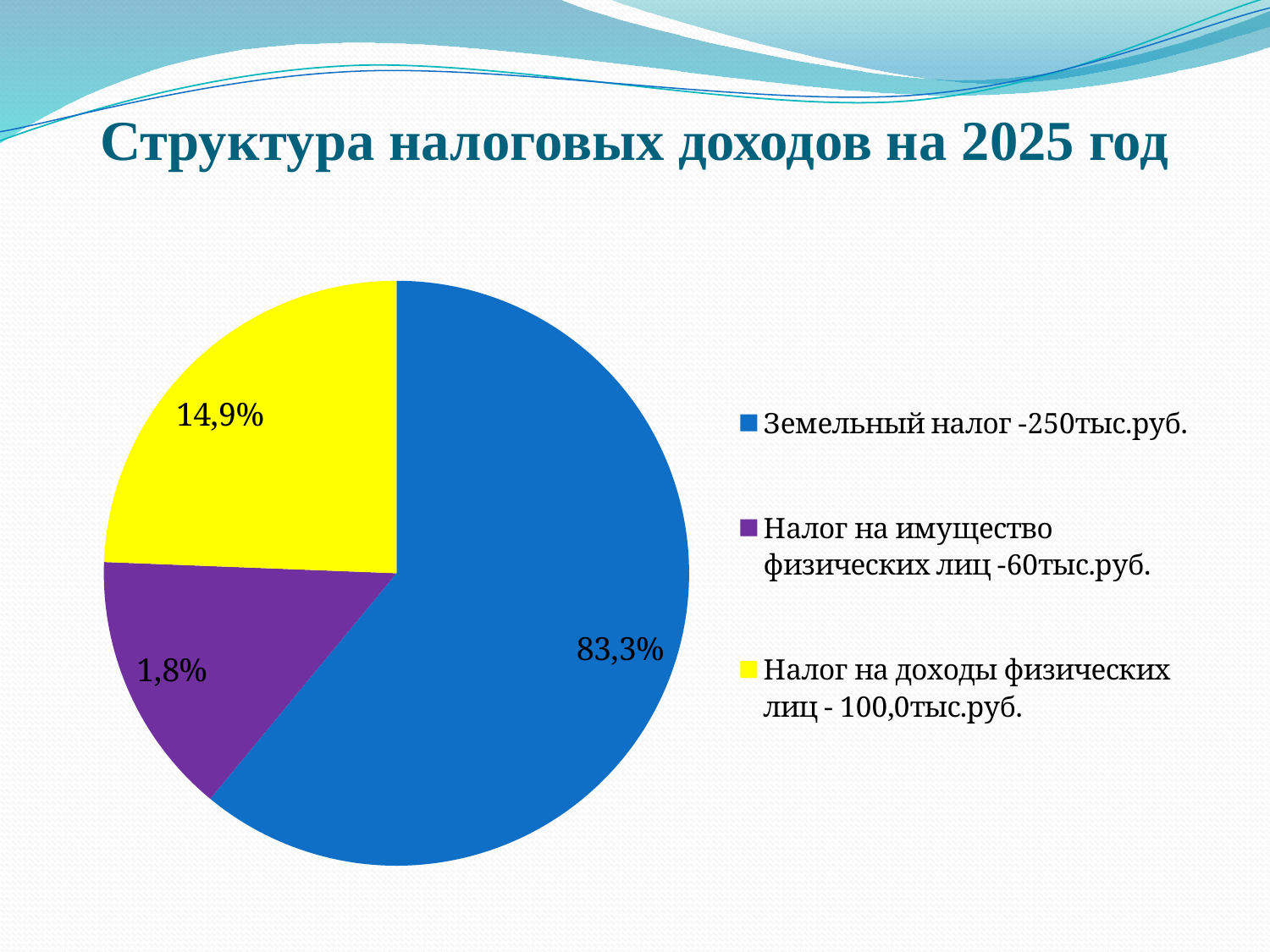
What percentage is shown for Налог на доходы физических лиц? 14,9% Which category has the largest share of the pie? Земельный налог What is the title of the chart on the slide? Структура налоговых доходов на 2025 год What type of chart is shown on the slide? Pie chart Which is larger: the share for Земельный налог or the share for Налог на доходы физических лиц? Земельный налог How many slices does the pie chart have? 3 What percentage is shown for Земельный налог? 83,3% What percentage is shown for Налог на имущество физических лиц? 1,8% What colour is the slice for Налог на доходы физических лиц? Yellow How many entries does the legend list? 3 What is the difference in percentage points between the Земельный налог share and the Налог на доходы физических лиц share? 68,4 Which category has the smallest share of the pie? Налог на имущество физических лиц